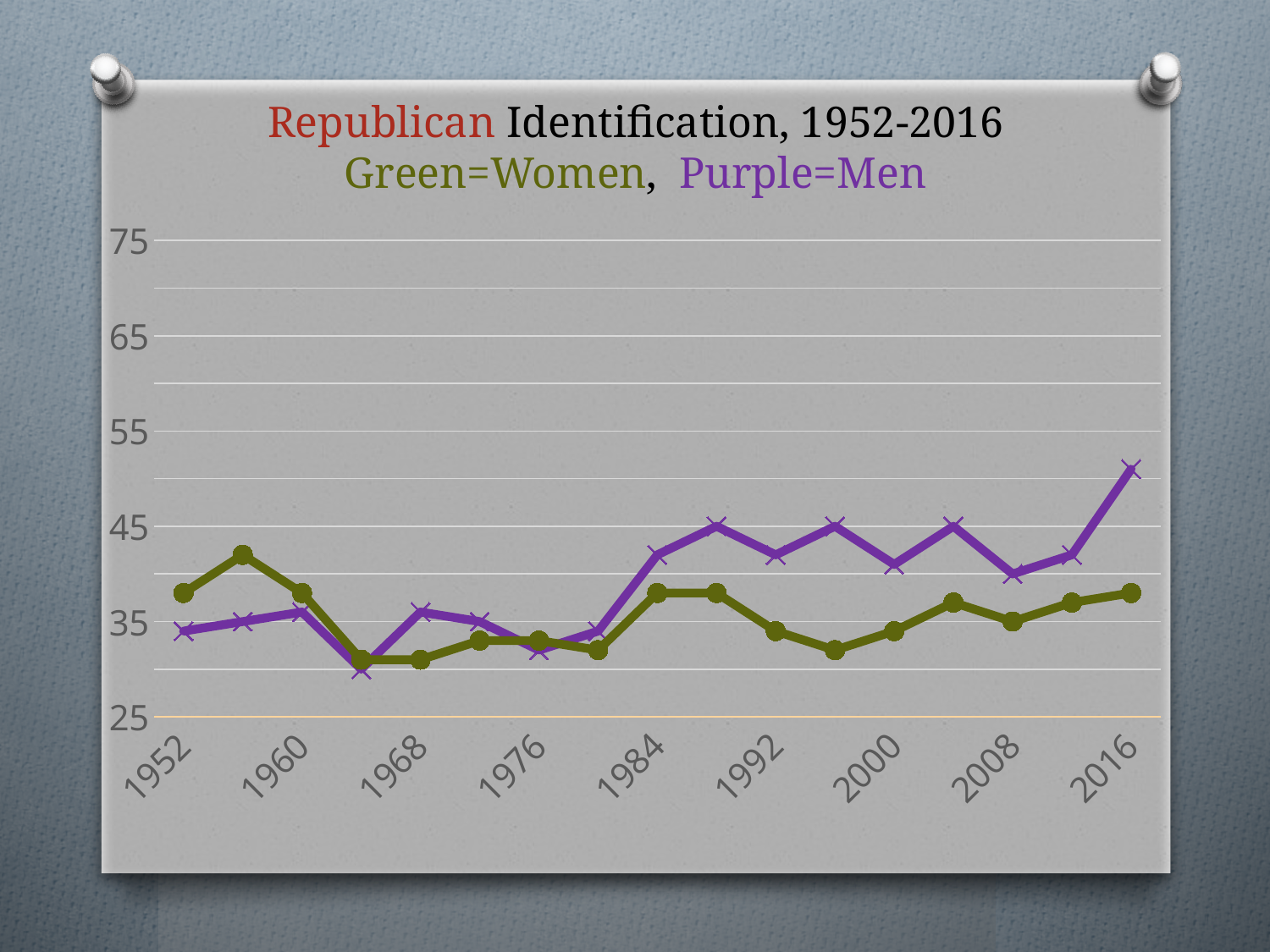
In which year does the Men series reach its highest value? 2016 How many data series are plotted on the chart? 2 How many year labels are shown on the x axis? 9 Is the value for Women in 2016 greater or less than 45? less Is the value for Men in 1964 greater or less than 35? less In 1952, which series has the higher value, Men or Women? Women Is the value for Men in 2016 greater or less than 45? greater What kind of chart is shown on the slide? line chart In 2016, which series has the higher value, Men or Women? Men What is the title of the chart? Republican Identification, 1952-2016 Which colour represents Women on the chart? Green